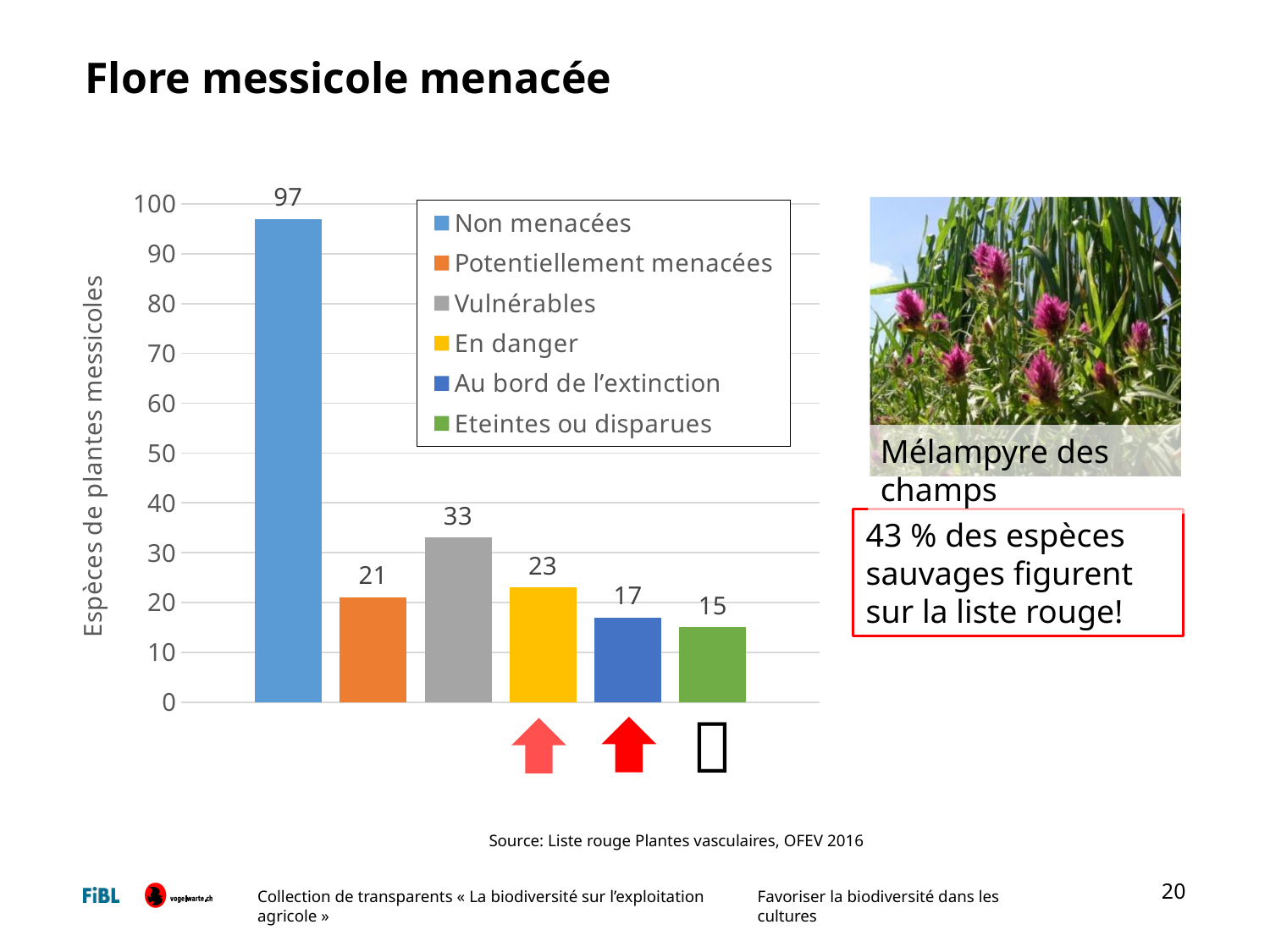
What is the label of the vertical axis? Espèces de plantes messicoles What is the difference between 'En danger' and 'Au bord de l'extinction'? 6 What is the value for 'Eteintes ou disparues'? 15 What is the difference between 'Non menacées' and 'Vulnérables'? 64 What kind of chart is shown on the slide? Bar chart How many entries does the legend list? 6 How many categories are plotted in the chart? 6 Which category has the highest value? Non menacées Which category has the lowest value? Eteintes ou disparues Which is larger, 'Potentiellement menacées' or 'En danger'? En danger What is the value for 'Vulnérables'? 33 How many species are in the 'Non menacées' category? 97